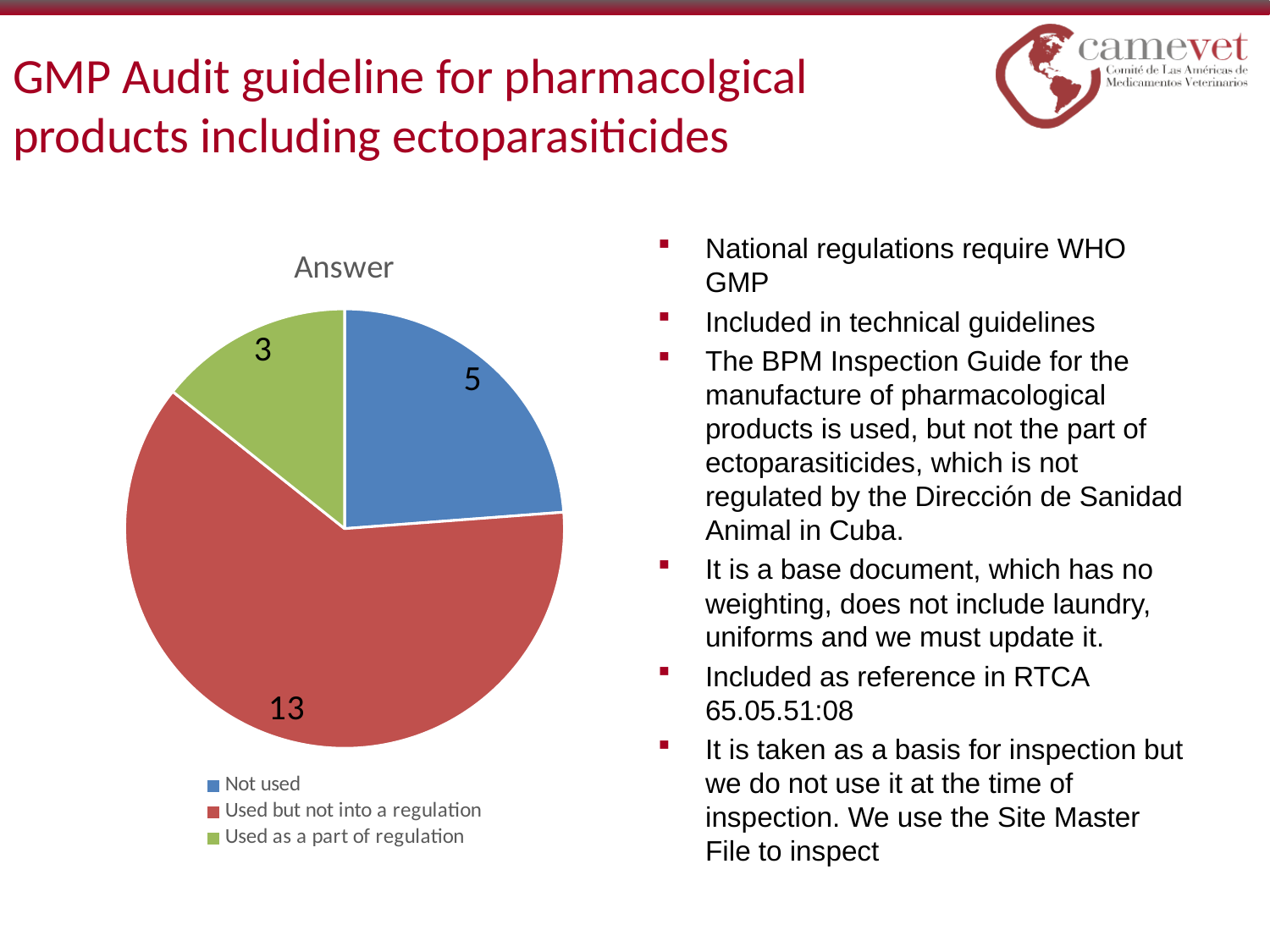
Which category has the largest slice of the pie? Used but not into a regulation Which colour represents "Used but not into a regulation" in the legend? Red What is the difference between the values for "Used but not into a regulation" and "Not used"? 8 What is the value for "Used as a part of regulation"? 3 Which category has the smallest slice of the pie? Used as a part of regulation What is the value for "Not used"? 5 How many categories does the pie chart have? 3 What is the title of the chart? Answer What type of chart is shown on the slide? Pie chart What is the total of all the slices in the pie chart? 21 What is the value for "Used but not into a regulation"? 13 Which is larger, the value for "Not used" or the value for "Used as a part of regulation"? Not used